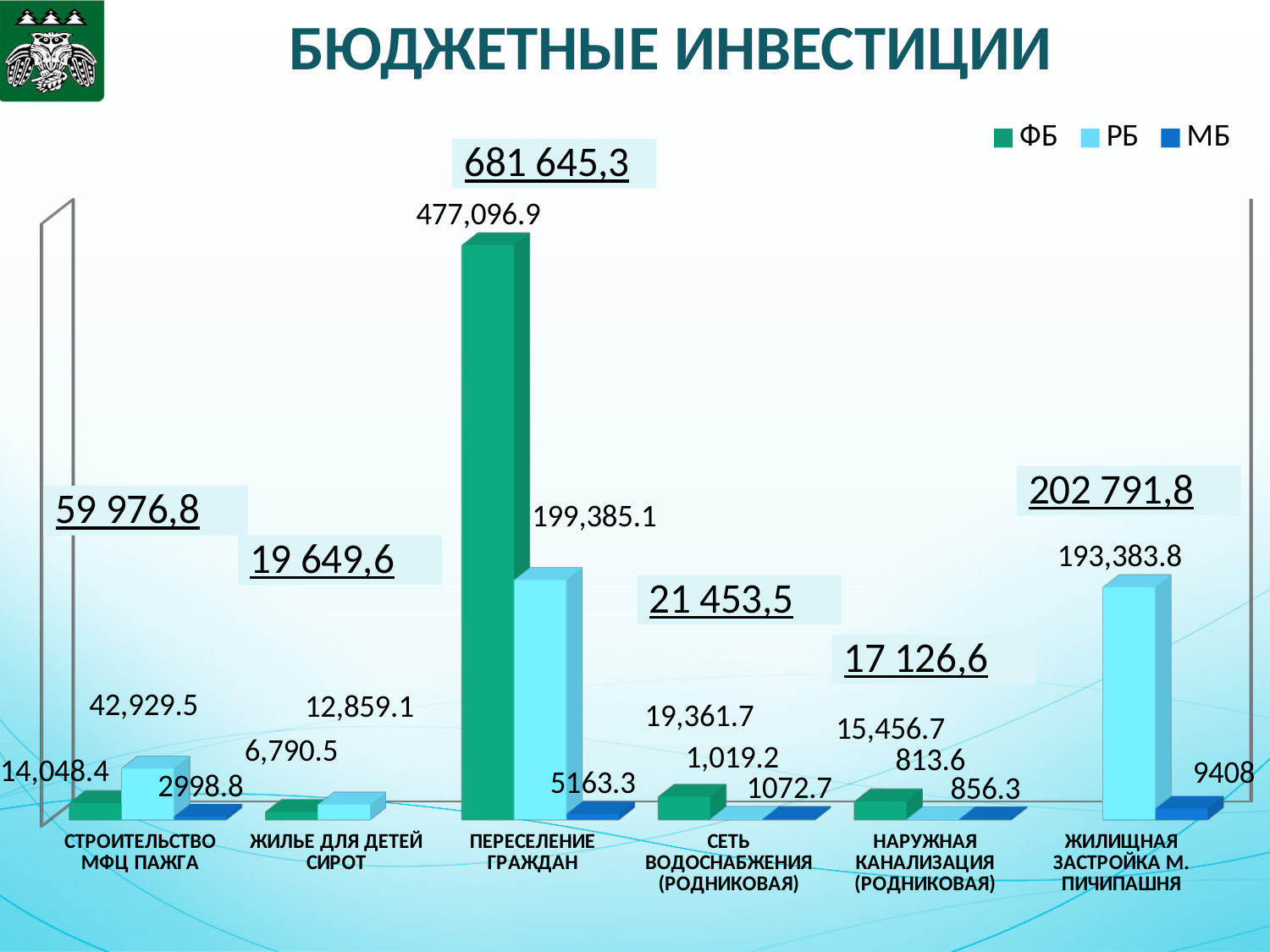
Which category has the lowest РБ value? НАРУЖНАЯ КАНАЛИЗАЦИЯ (РОДНИКОВАЯ) What total is printed above the bars for НАРУЖНАЯ КАНАЛИЗАЦИЯ (РОДНИКОВАЯ)? 17 126,6 What is the МБ value for СТРОИТЕЛЬСТВО МФЦ ПАЖГА? 2998.8 How many categories are shown along the x axis? 6 What is the difference between the ФБ and РБ values for ПЕРЕСЕЛЕНИЕ ГРАЖДАН? 277,711.8 Which is larger for СЕТЬ ВОДОСНАБЖЕНИЯ (РОДНИКОВАЯ): the РБ value or the МБ value? МБ How many series does the legend list? 3 Which category has the highest ФБ value? ПЕРЕСЕЛЕНИЕ ГРАЖДАН What kind of chart is shown on the slide? bar chart What is the РБ value for ЖИЛИЩНАЯ ЗАСТРОЙКА М. ПИЧИПАШНЯ? 193,383.8 What is the РБ value for ЖИЛЬЕ ДЛЯ ДЕТЕЙ СИРОТ? 12,859.1 What is the ФБ value for ПЕРЕСЕЛЕНИЕ ГРАЖДАН? 477,096.9